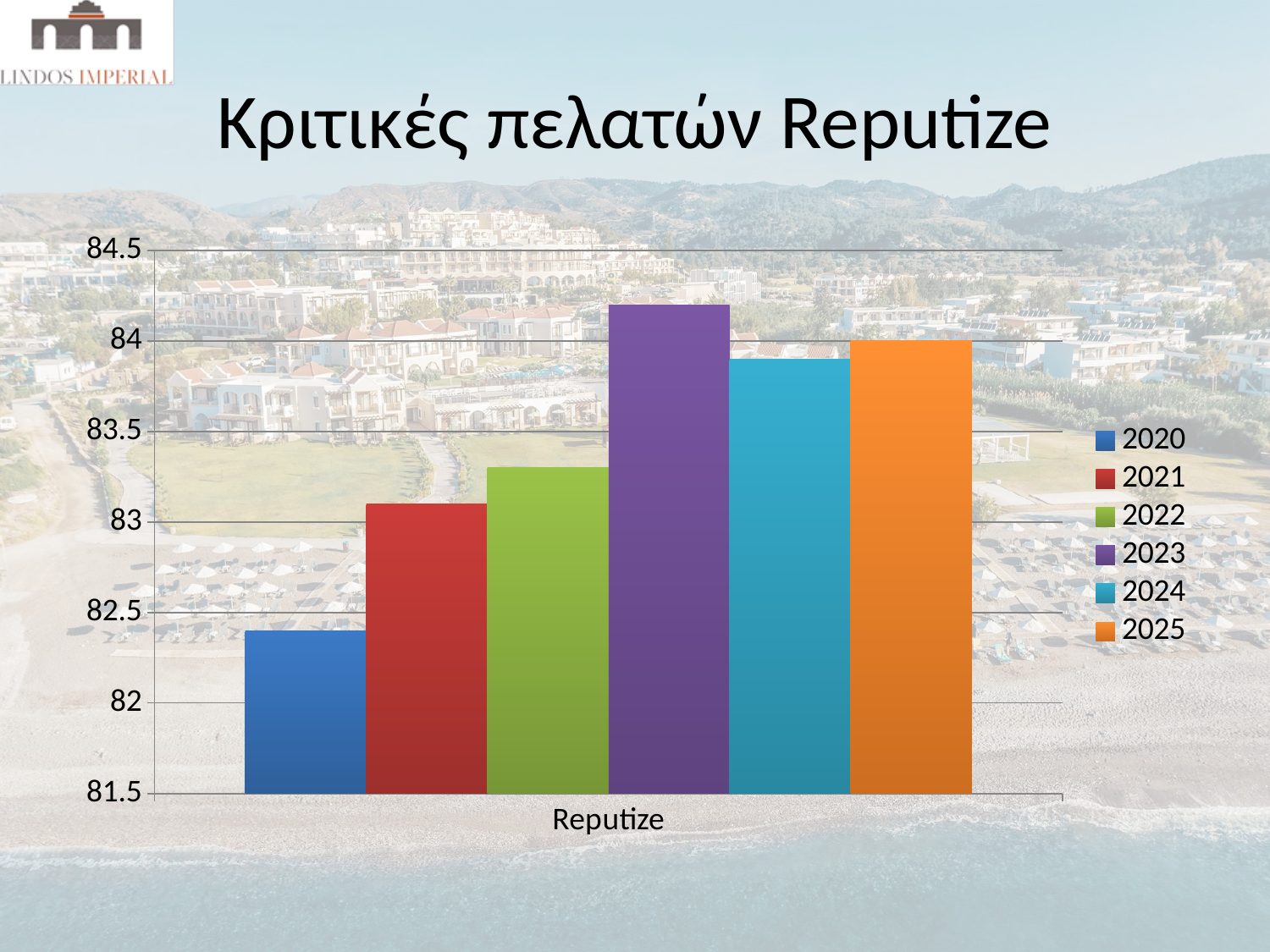
Is the value for 2023 greater or less than 84? greater What kind of chart is shown on the slide? bar chart Which is larger, the value for 2020 or the value for 2021? 2021 Which year has the highest bar? 2023 Is the value for 2022 greater or less than 83.5? less What colour is the bar for 2023? purple Which year has the lowest bar? 2020 Which is larger, the value for 2023 or the value for 2024? 2023 What is the category label shown on the x axis? Reputize Is the value for 2021 greater or less than 83? greater How many series does the legend list? 6